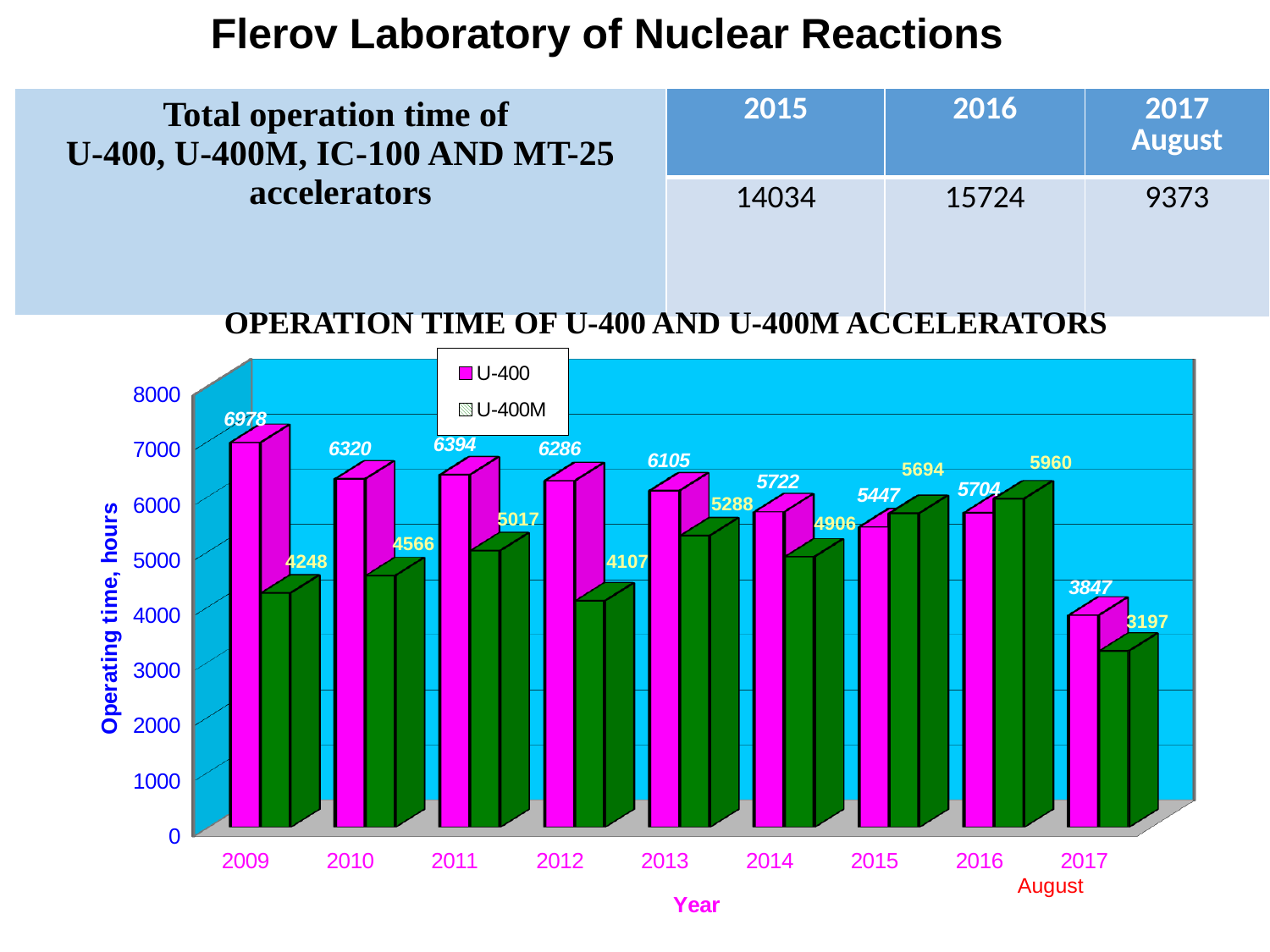
Which year has the lowest U-400M operating time? 2017 August Which year has the highest U-400 operating time? 2009 In 2015, which accelerator has the larger operating time, U-400 or U-400M? U-400M What is the title of the chart? OPERATION TIME OF U-400 AND U-400M ACCELERATORS How many years are shown on the x axis of the chart? 9 What kind of chart is shown on the slide? bar chart Is the U-400M operating time for 2010 greater or less than 5000? less How many series does the chart legend list? 2 What is the difference between the U-400 and U-400M operating times in 2013? 817 What is the U-400M operating time for 2016? 5960 What is the U-400 operating time for 2009? 6978 What is the U-400M operating time for 2012? 4107